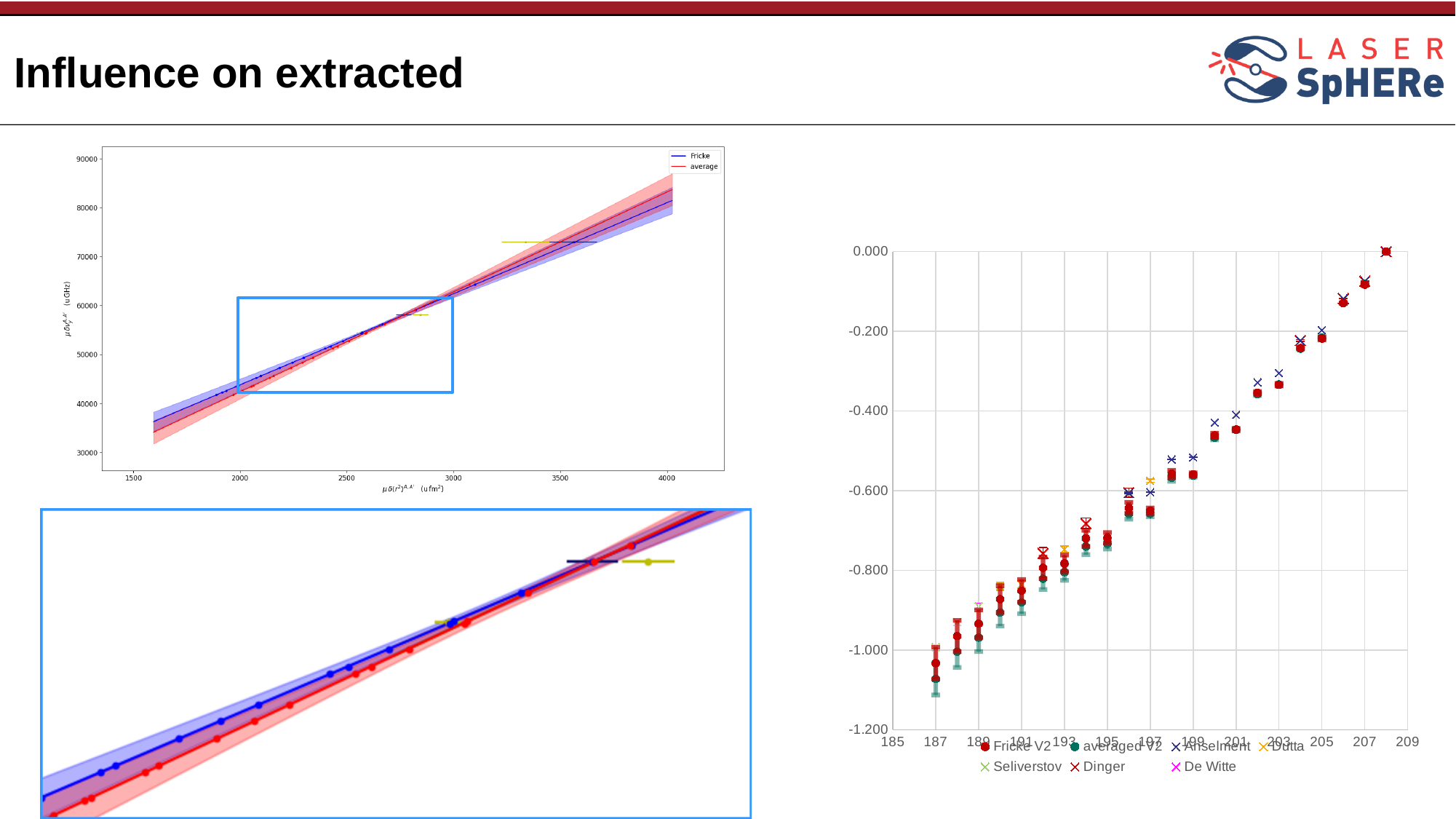
On the right-hand chart, do the plotted values rise or fall as the x axis increases from 187 to 208? rise On the right-hand chart, how many series does the legend list? 7 On the top-left chart, what kind of chart is shown? line chart On the right-hand chart, which series is listed first in the legend? Fricke V2 On the right-hand chart, is the Fricke V2 value at x = 201 greater or less than -0.400? less On the top-left chart, what are the two legend entries? Fricke and average On the right-hand chart, is the Fricke V2 value at x = 205 greater or less than -0.400? greater On the top-left chart, how many series does the legend list? 2 On the top-left chart, do the fitted lines rise or fall as the x axis increases from 1500 to 4000? rise On the right-hand chart, is the Fricke V2 value at x = 195 greater or less than -0.600? less On the right-hand chart, what kind of chart is shown? scatter chart